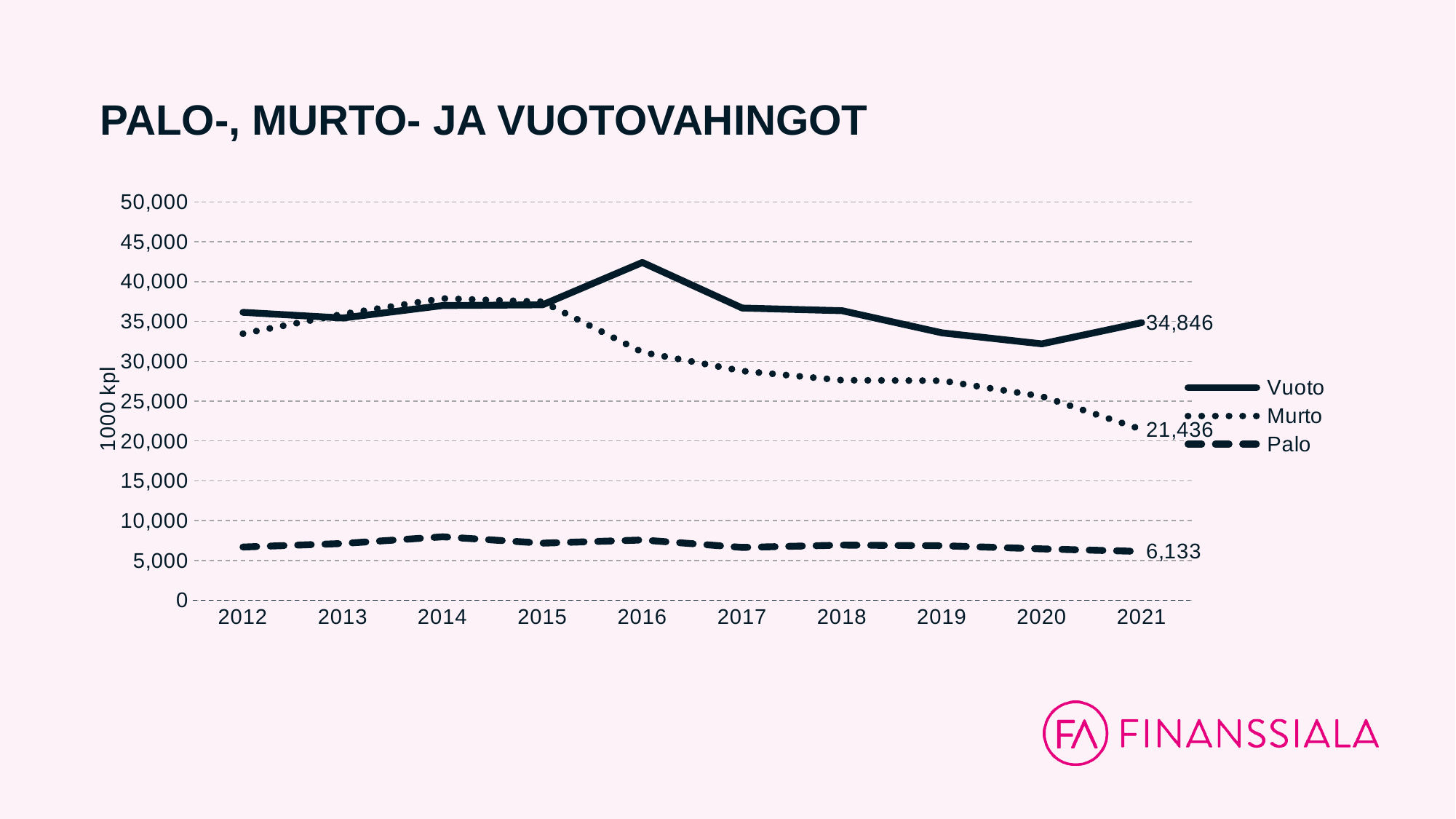
Is the value for Murto in 2018 greater or less than 30,000? less What is the value for Murto in 2021? 21,436 Is the value for Vuoto in 2016 greater or less than 40,000? greater In which year does the Vuoto series reach its highest value? 2016 What is the value for Vuoto in 2021? 34,846 Which series has the larger value in 2021, Vuoto or Murto? Vuoto How many series does the legend list? 3 How many years are shown on the x axis? 10 What kind of chart is shown on the slide? line chart What is the value for Palo in 2021? 6,133 What is the difference between the Murto and Palo values in 2021? 15,303 What is the difference between the Vuoto and Murto values in 2021? 13,410